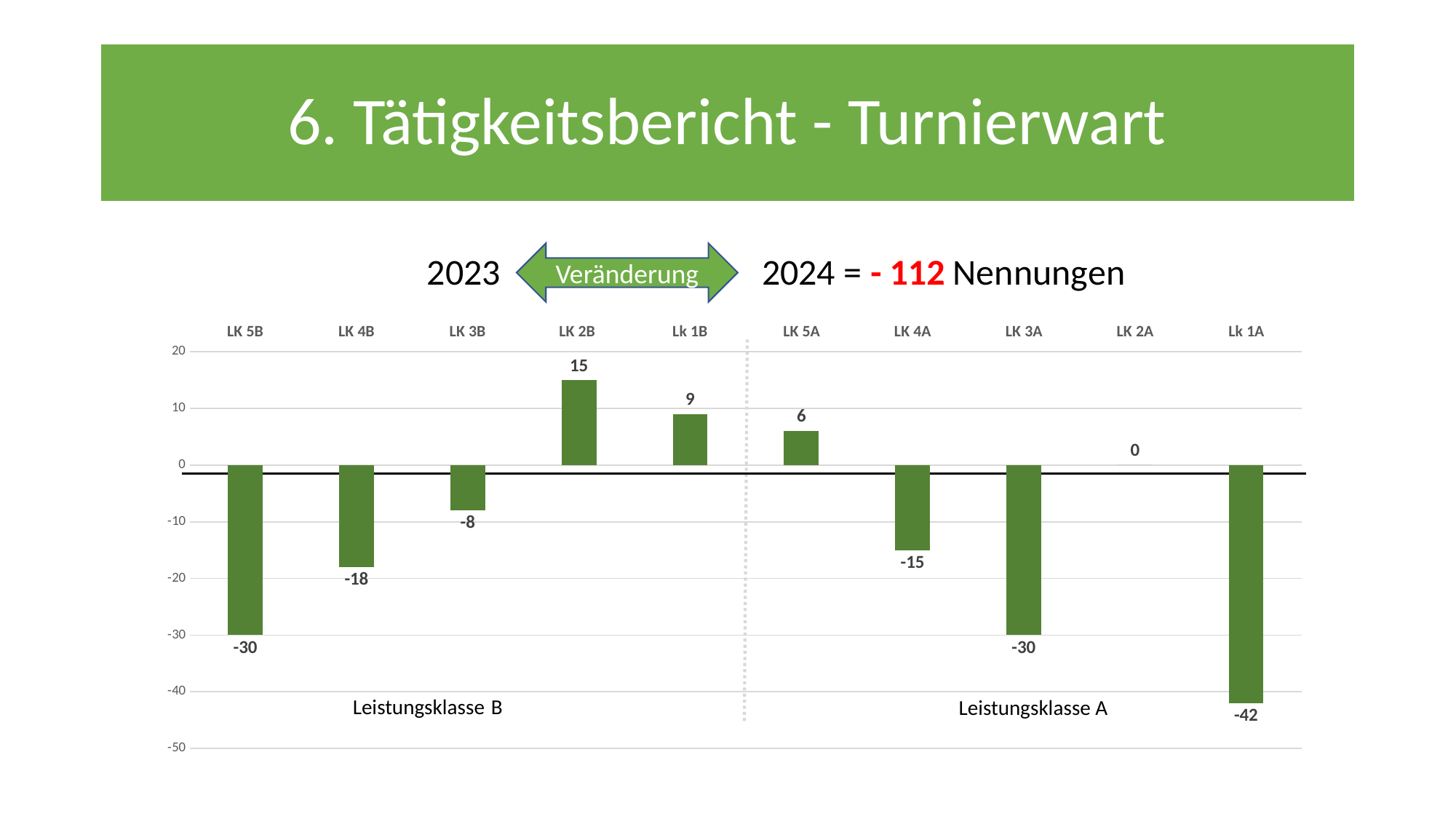
Which category has the highest value? LK 2B Which category has the lowest value? Lk 1A What is the value for Lk 1A? -42 What is the difference between the values for LK 2B and Lk 1B? 6 What is the value for LK 5B? -30 What kind of chart is shown on the slide? bar chart What is the value for LK 2B? 15 What are the two group labels shown below the bars? Leistungsklasse B and Leistungsklasse A Which is larger, the value for LK 5A or the value for Lk 1B? Lk 1B How many categories are shown on the chart? 10 Is the value for LK 4A greater or less than -10? less What is the value for LK 2A? 0